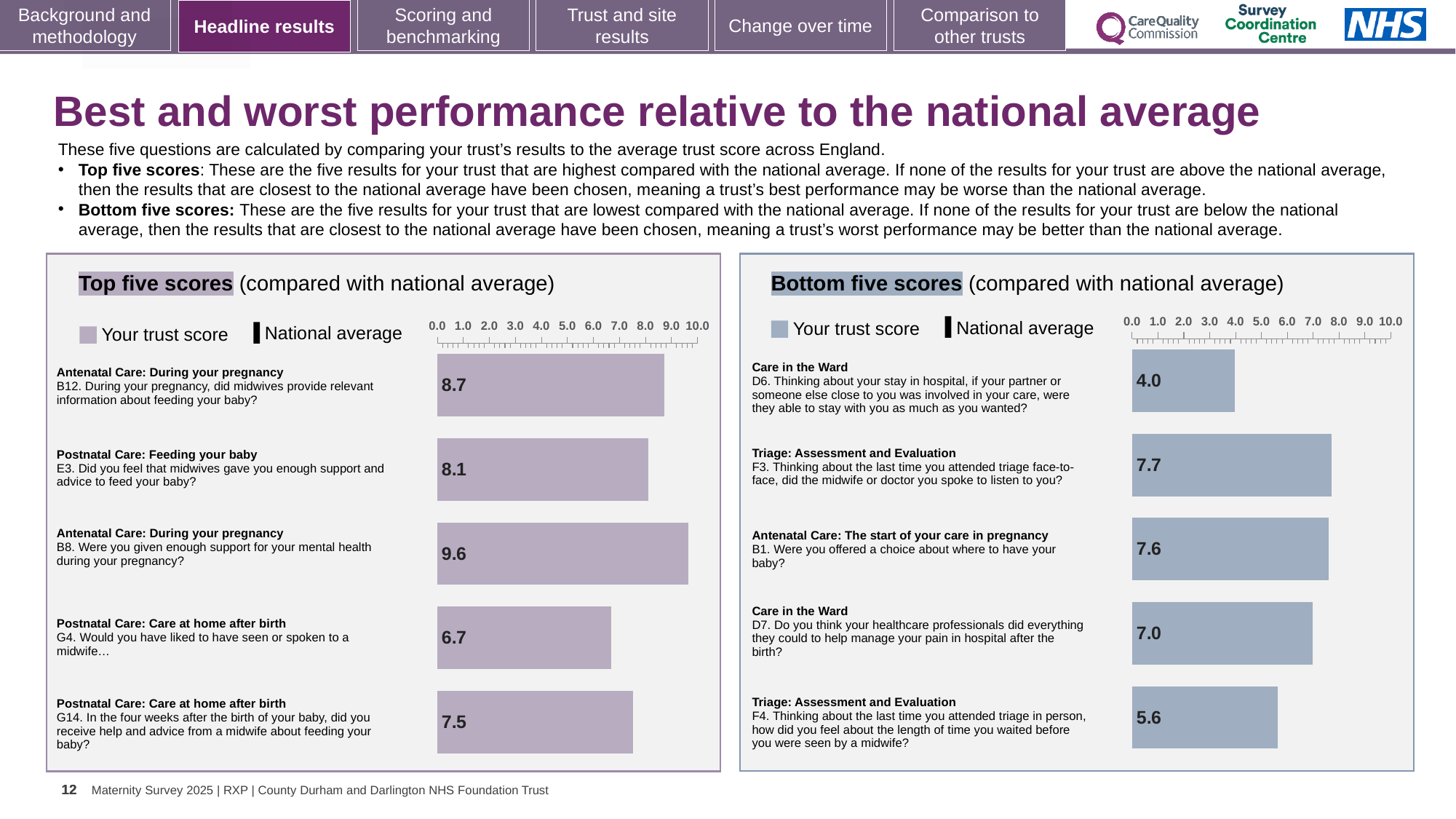
How many entries does the legend of the Top five scores chart list? 2 In the Top five scores chart, which has the higher trust score, B12 or E3? B12 In the Bottom five scores chart, what is the trust score for D6 (were they able to stay with you as much as you wanted?)? 4.0 In the Top five scores chart, which question has the lowest trust score? G4 (Postnatal Care: Care at home after birth) In the Top five scores chart, what is the difference between the trust scores for B8 and G4? 2.9 What type of chart is the Top five scores chart? Bar chart In the Top five scores chart, what is the trust score for B8 (Were you given enough support for your mental health during your pregnancy?)? 9.6 In the Bottom five scores chart, which question has the lowest trust score? D6 (Care in the Ward) In the Bottom five scores chart, what is the difference between the trust scores for F3 and D6? 3.7 In the Top five scores chart, which question has the highest trust score? B8 (Antenatal Care: During your pregnancy) In the Top five scores chart, what is the trust score for G14 (help and advice from a midwife about feeding your baby)? 7.5 How many bars are shown in the Bottom five scores chart? 5